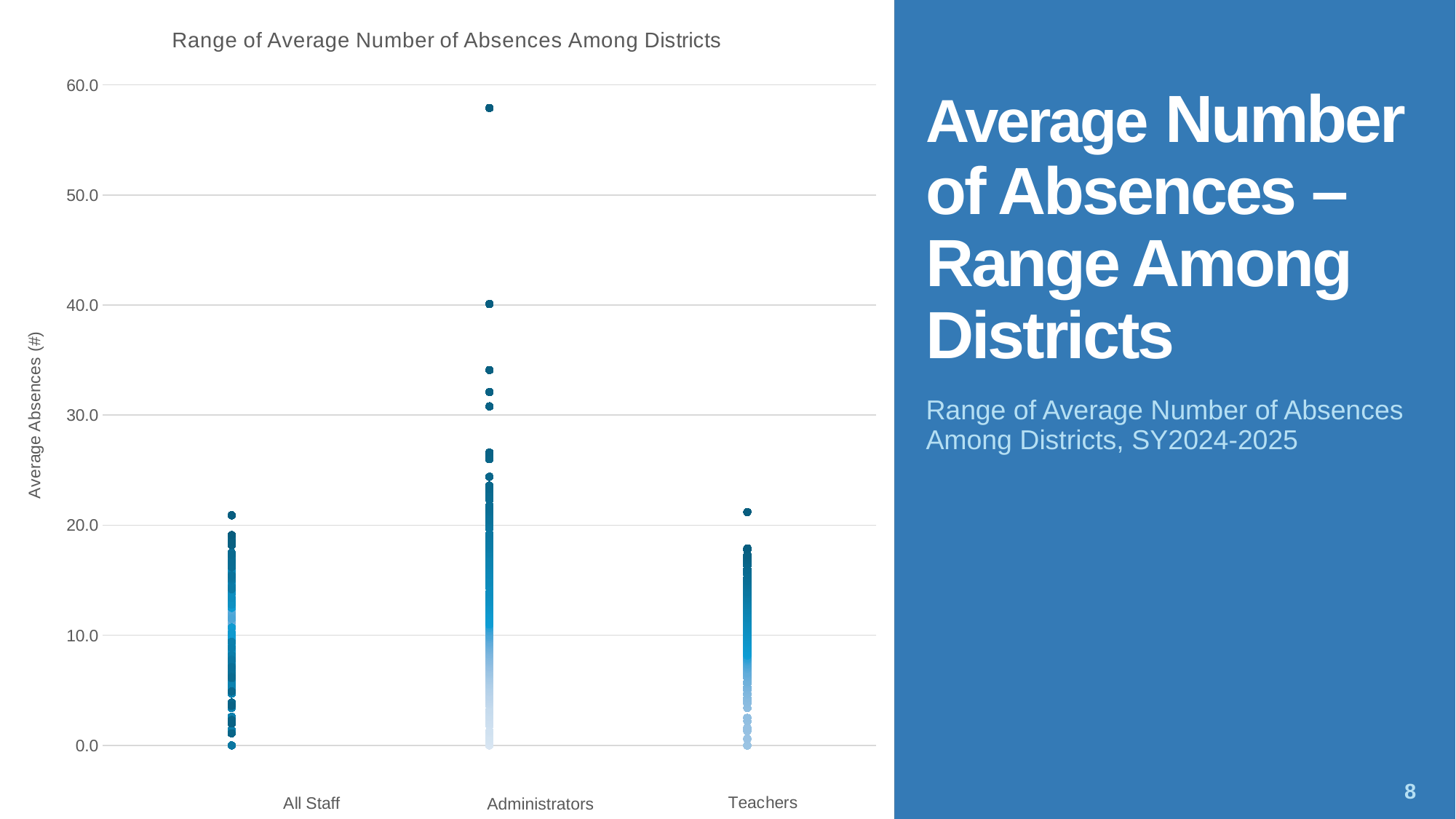
What is the label on the y axis of the chart? Average Absences (#) Is the highest value for All Staff greater or less than 30? less What is the title of the chart? Range of Average Number of Absences Among Districts How many categories are shown on the x axis of the chart? 3 What is the highest tick value shown on the y axis? 60.0 What kind of chart is shown on the slide? Scatter (dot) plot Which category has a higher maximum value, All Staff or Administrators? Administrators Which category has the highest plotted value in the chart? Administrators Is the highest value for Administrators greater or less than 40? greater Is the highest value for Teachers greater or less than 30? less